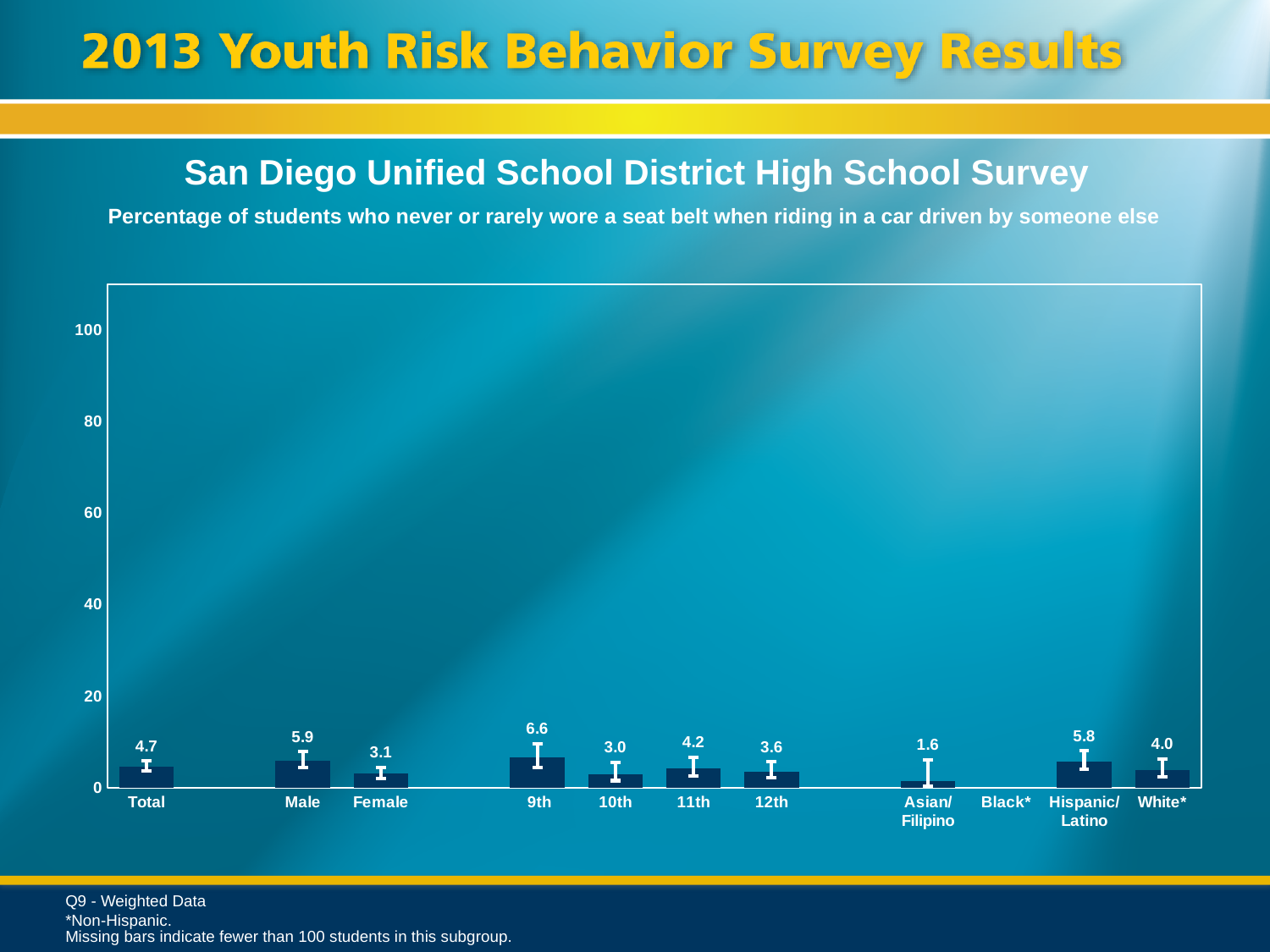
Which category with a plotted bar has the lowest value? Asian/Filipino What is the difference between the Male and Female values? 2.8 What is the value for Total? 4.7 Which category has the highest value? 9th What kind of chart is shown? bar chart What is the value for Asian/Filipino? 1.6 What is the value for 9th grade? 6.6 What is the value for Male? 5.9 Which category has no bar plotted? Black* What is the value for Female? 3.1 Which is larger, the value for Hispanic/Latino or the value for White*? Hispanic/Latino Is the value for 11th grade greater or less than 20? less